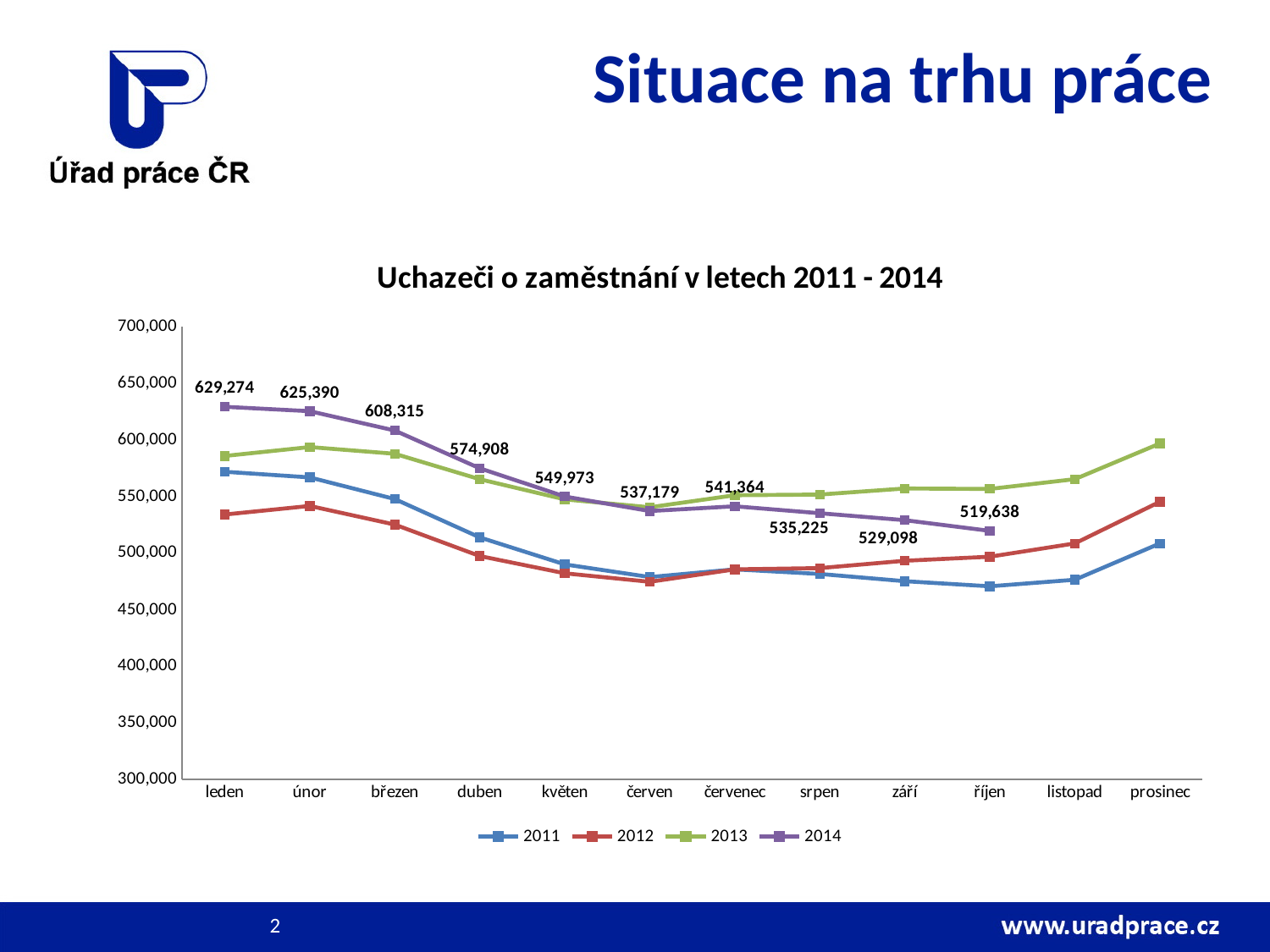
Which is larger, the 2014 value for červen or for červenec? červenec How many months are shown on the x axis? 12 What is the value for 2014 in leden? 629,274 Does the 2014 series rise or fall from leden to říjen? fall In which month is the 2014 series highest? leden What kind of chart is shown? line chart Is the value for 2011 in prosinec greater or less than 550,000? less What is the difference between the 2014 values for leden and únor? 3,884 What is the value for 2014 in červenec? 541,364 In which month is the 2014 series lowest? říjen How many series does the legend list? 4 What is the value for 2014 in říjen? 519,638